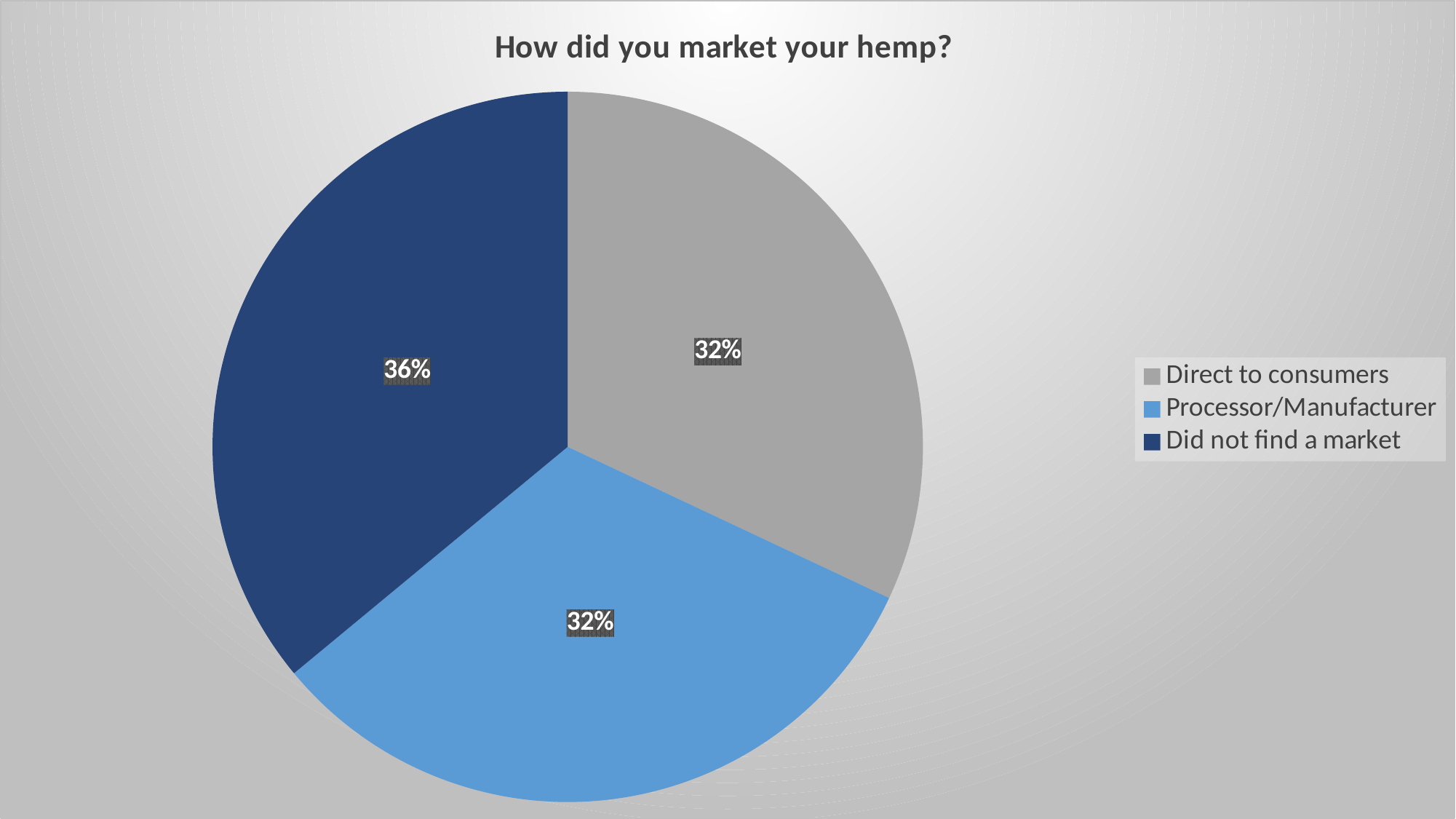
What is the title of the chart? How did you market your hemp? What is the combined share of 'Direct to consumers' and 'Processor/Manufacturer'? 64% What percentage of respondents marketed their hemp to a processor/manufacturer? 32% Which colour represents 'Processor/Manufacturer' in the chart? light blue What percentage of respondents did not find a market? 36% How many categories does the legend list? 3 Which is larger: the share for 'Did not find a market' or the share for 'Processor/Manufacturer'? Did not find a market What percentage of respondents marketed their hemp direct to consumers? 32% What type of chart is shown on the slide? pie chart Which category has the largest share of the pie? Did not find a market What is the difference between the share for 'Did not find a market' and the share for 'Direct to consumers'? 4%